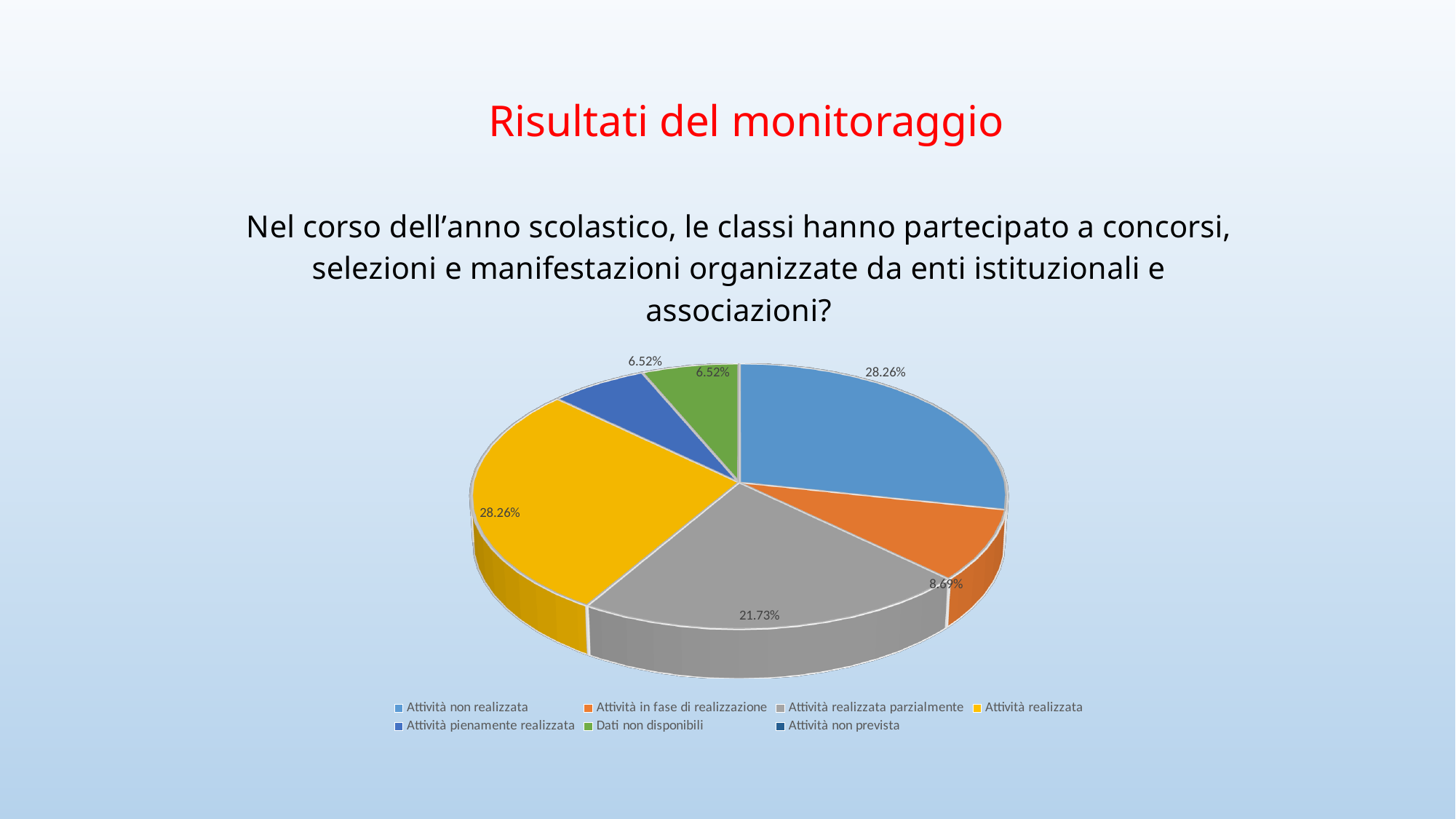
Which is larger, the "Attività realizzata parzialmente" slice or the "Attività in fase di realizzazione" slice? Attività realizzata parzialmente What percentage does the "Attività realizzata parzialmente" slice show? 21.73% What percentage is shown for "Dati non disponibili"? 6.52% What percentage is shown for "Attività realizzata"? 28.26% How many entries does the chart legend list? 7 What is the difference in percentage points between the "Attività in fase di realizzazione" slice and the "Dati non disponibili" slice? 2.17 What kind of chart is shown on the slide? Pie chart What percentage of the pie is labelled "Attività non realizzata"? 28.26% What is the title of the slide containing the chart? Risultati del monitoraggio What colour is the "Attività realizzata" slice in the pie chart? Yellow What is the difference in percentage points between the "Attività non realizzata" slice and the "Attività realizzata parzialmente" slice? 6.53 What is the value shown for "Attività in fase di realizzazione"? 8.69%